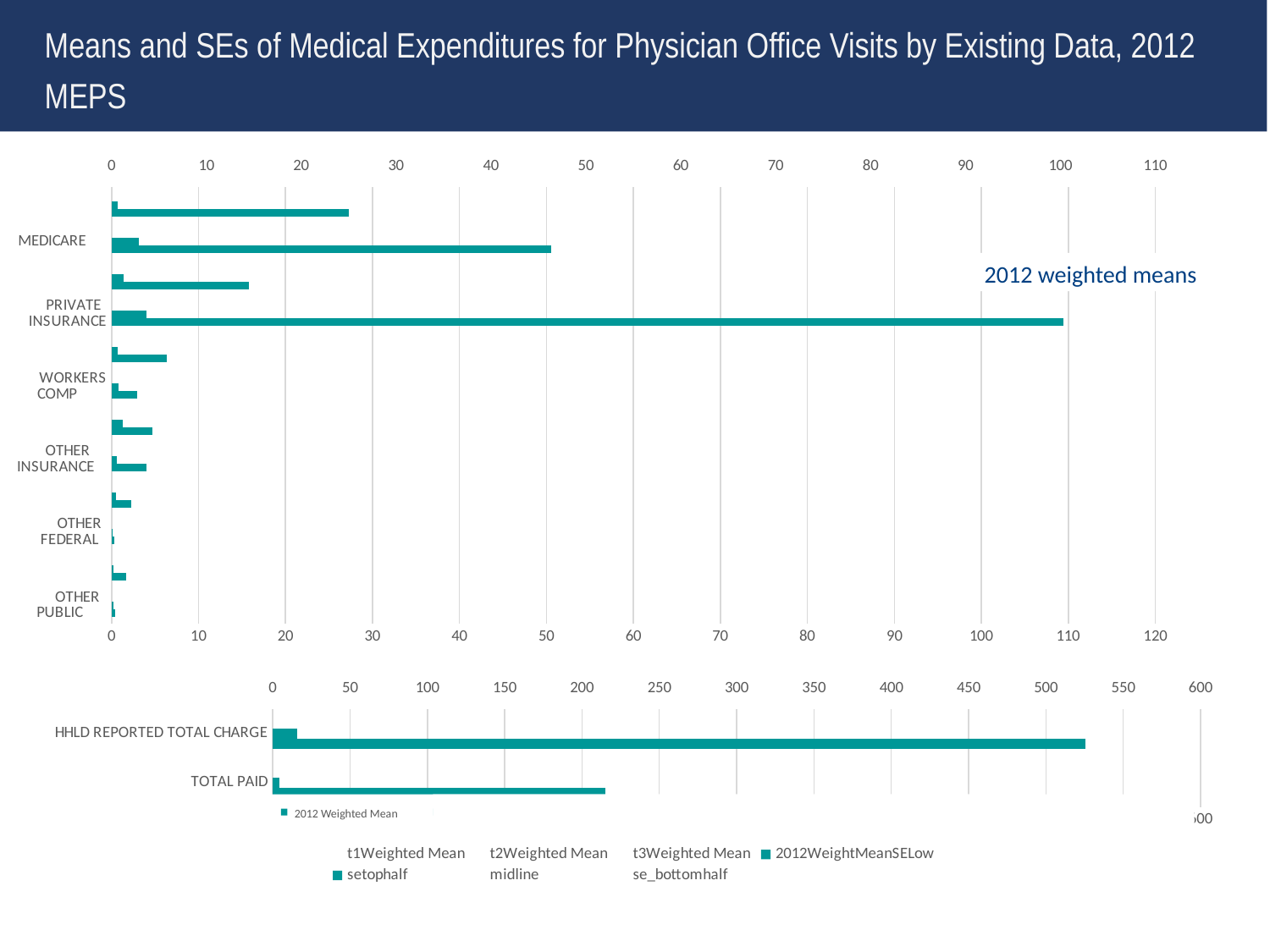
What text annotation appears in blue on the right side of the top chart? 2012 weighted means In the bottom chart, is the longest bar for TOTAL PAID greater or less than 250? less In the top chart, how many categories are listed on the vertical axis? 6 In the bottom chart, which category has the longer bar? HHLD REPORTED TOTAL CHARGE In the bottom chart, is the longest bar for HHLD REPORTED TOTAL CHARGE greater or less than 500? greater In the bottom chart, how many categories are listed on the vertical axis? 2 In the top chart, which category has the longest bar? PRIVATE INSURANCE In the top chart, is the longest bar for MEDICARE greater or less than 40? greater In the top chart, which has a longer bar: MEDICARE or OTHER INSURANCE? MEDICARE What kind of chart is the top chart on the slide? bar chart